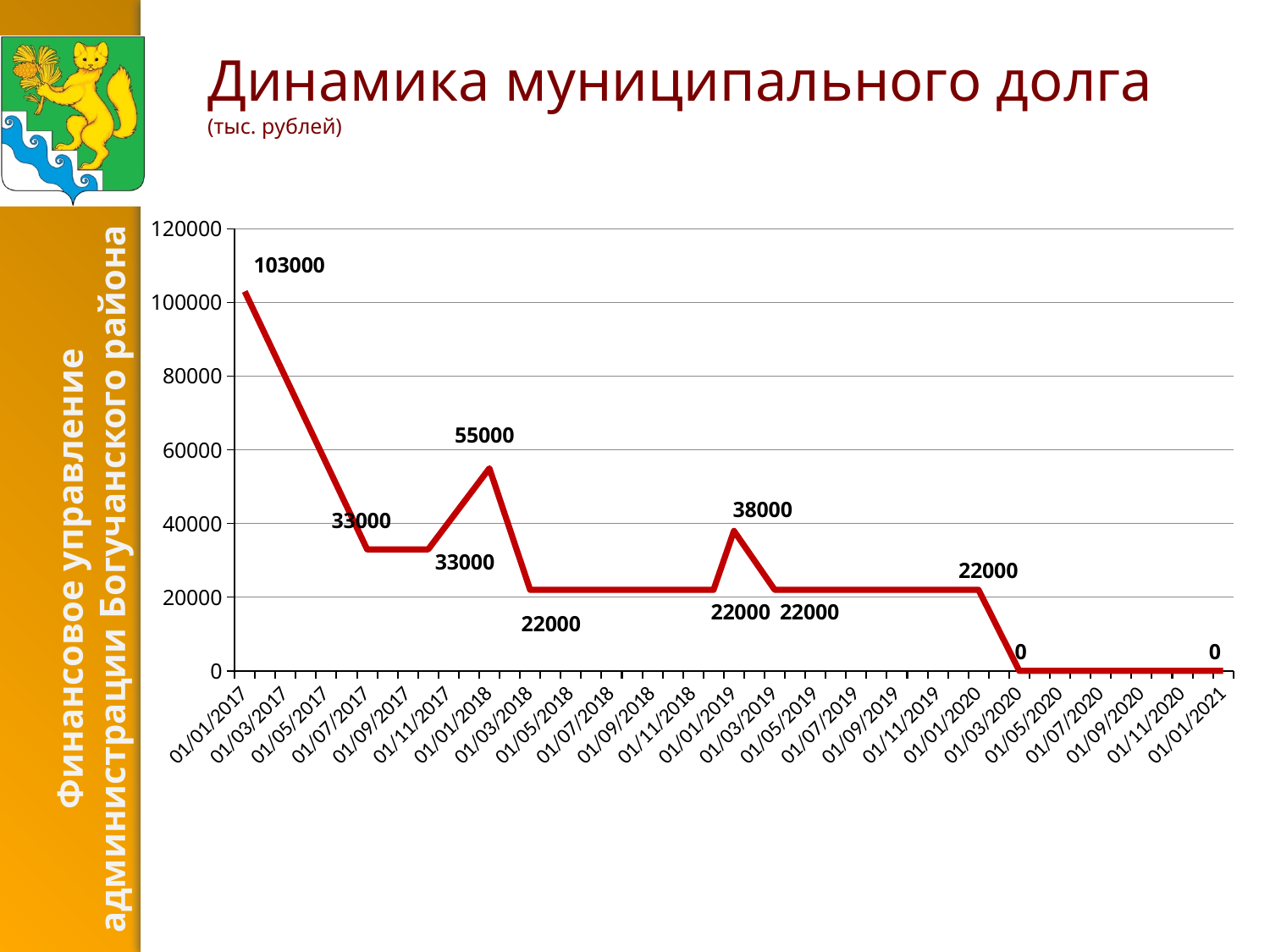
What is the value of municipal debt on 01/01/2018? 55000 What is the value of municipal debt on 01/01/2017? 103000 What is the difference between the debt on 01/01/2017 and on 01/01/2018? 48000 Is the value for 01/07/2019 greater or less than 40000? less What is the value of municipal debt on 01/01/2021? 0 On which date is the municipal debt highest? 01/01/2017 What is the value of municipal debt on 01/01/2019? 38000 Overall, do the values rise or fall from 01/01/2017 to 01/01/2021? fall What is the title of the chart? Динамика муниципального долга What kind of chart is shown on the slide? line chart Which is larger: the debt on 01/01/2018 or on 01/01/2019? 01/01/2018 What is the highest value shown on the y axis? 120000